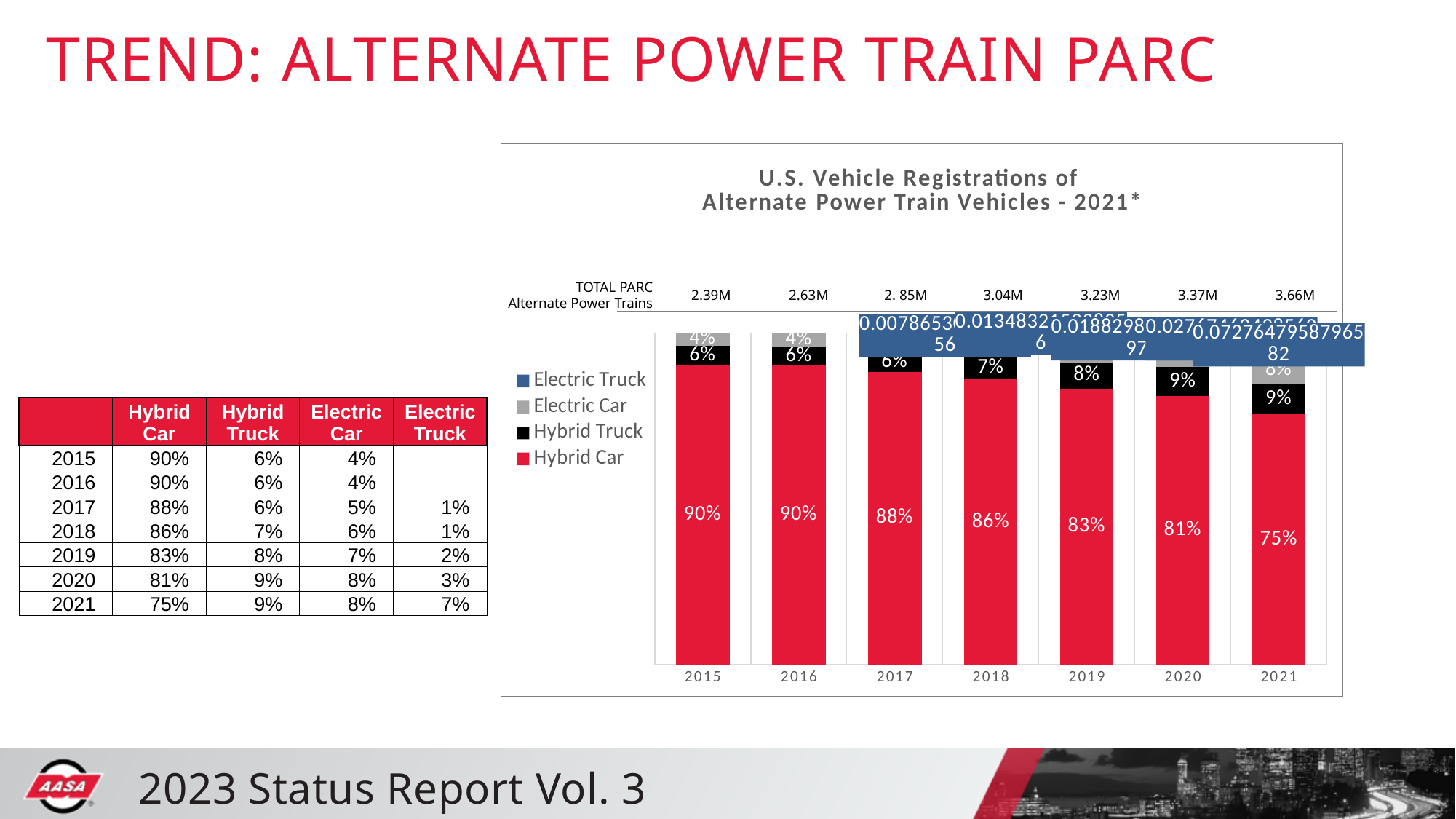
What is the Hybrid Car share shown for 2021 in the chart? 75% What is the Hybrid Truck share shown for 2018 in the chart? 7% How many series does the chart legend list? 4 How many years are shown on the x axis of the chart? 7 What kind of chart is shown on the slide? Stacked bar chart What is the Hybrid Truck share shown for 2020 in the chart? 9% Which year has the larger Hybrid Truck share, 2016 or 2019? 2019 By how many percentage points did the Hybrid Car share fall from 2015 to 2021? 15 percentage points Does the Hybrid Car share rise or fall from 2015 to 2021? Fall What is the Hybrid Car share shown for 2015 in the chart? 90% What is the TOTAL PARC value shown above the 2021 bar? 3.66M In which year is the Hybrid Car share the lowest? 2021